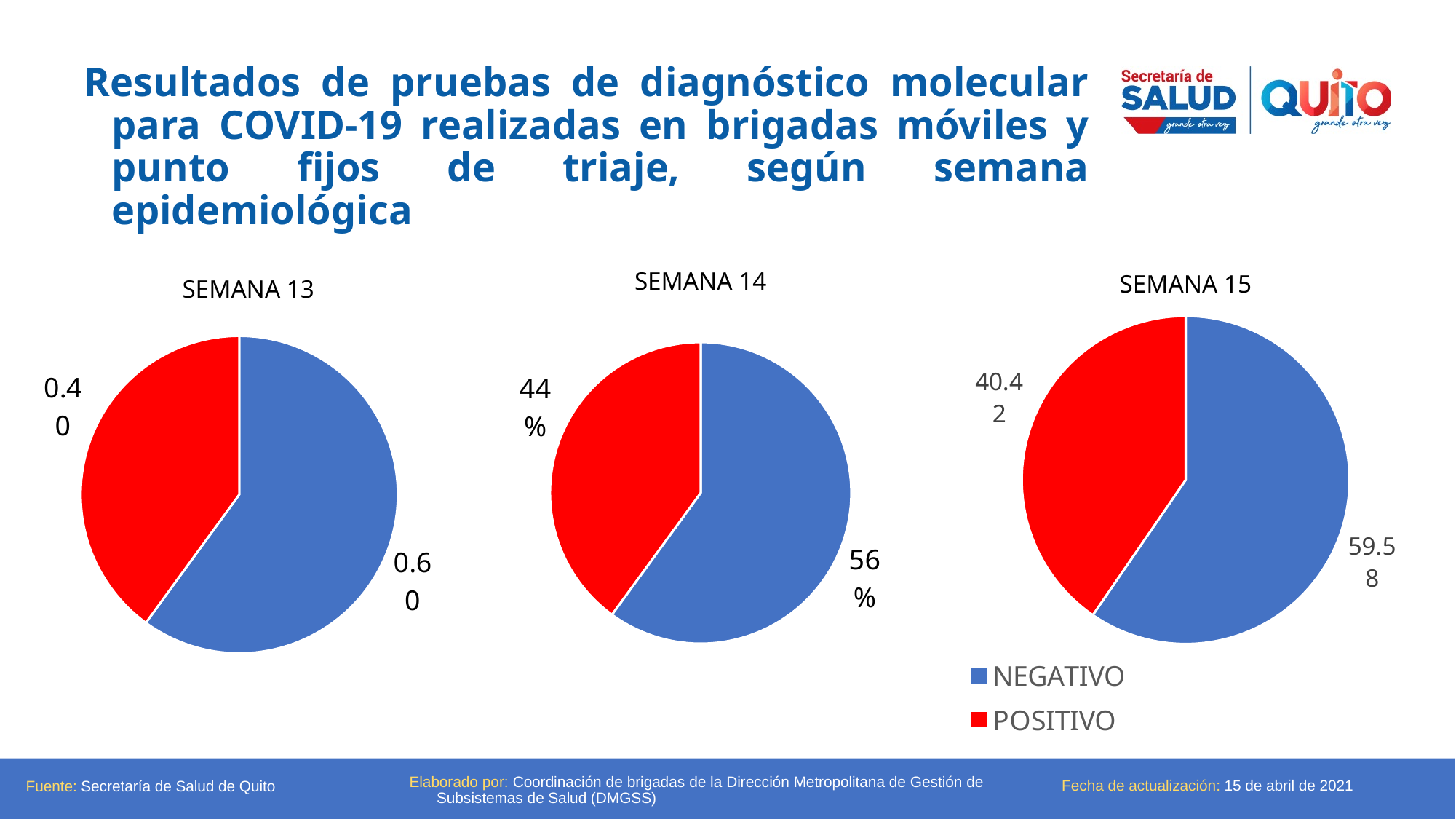
In the SEMANA 15 pie chart, which category has the smallest slice? POSITIVO In the SEMANA 15 pie chart, what is the value shown for POSITIVO? 40.42 In the SEMANA 13 pie chart, what is the value shown for NEGATIVO? 0.60 In the SEMANA 14 pie chart, what percentage is shown for NEGATIVO? 56% Which colour represents POSITIVO in the pie charts? Red In the SEMANA 14 pie chart, what is the difference between the NEGATIVO and POSITIVO percentages? 12% What type of chart is used for SEMANA 13, SEMANA 14 and SEMANA 15? Pie chart In the SEMANA 13 pie chart, what is the value shown for POSITIVO? 0.40 In the SEMANA 14 pie chart, which category has the larger share, NEGATIVO or POSITIVO? NEGATIVO In the SEMANA 15 pie chart, what is the value shown for NEGATIVO? 59.58 In the SEMANA 14 pie chart, what percentage is shown for POSITIVO? 44% How many categories does the legend list for the pie charts? 2